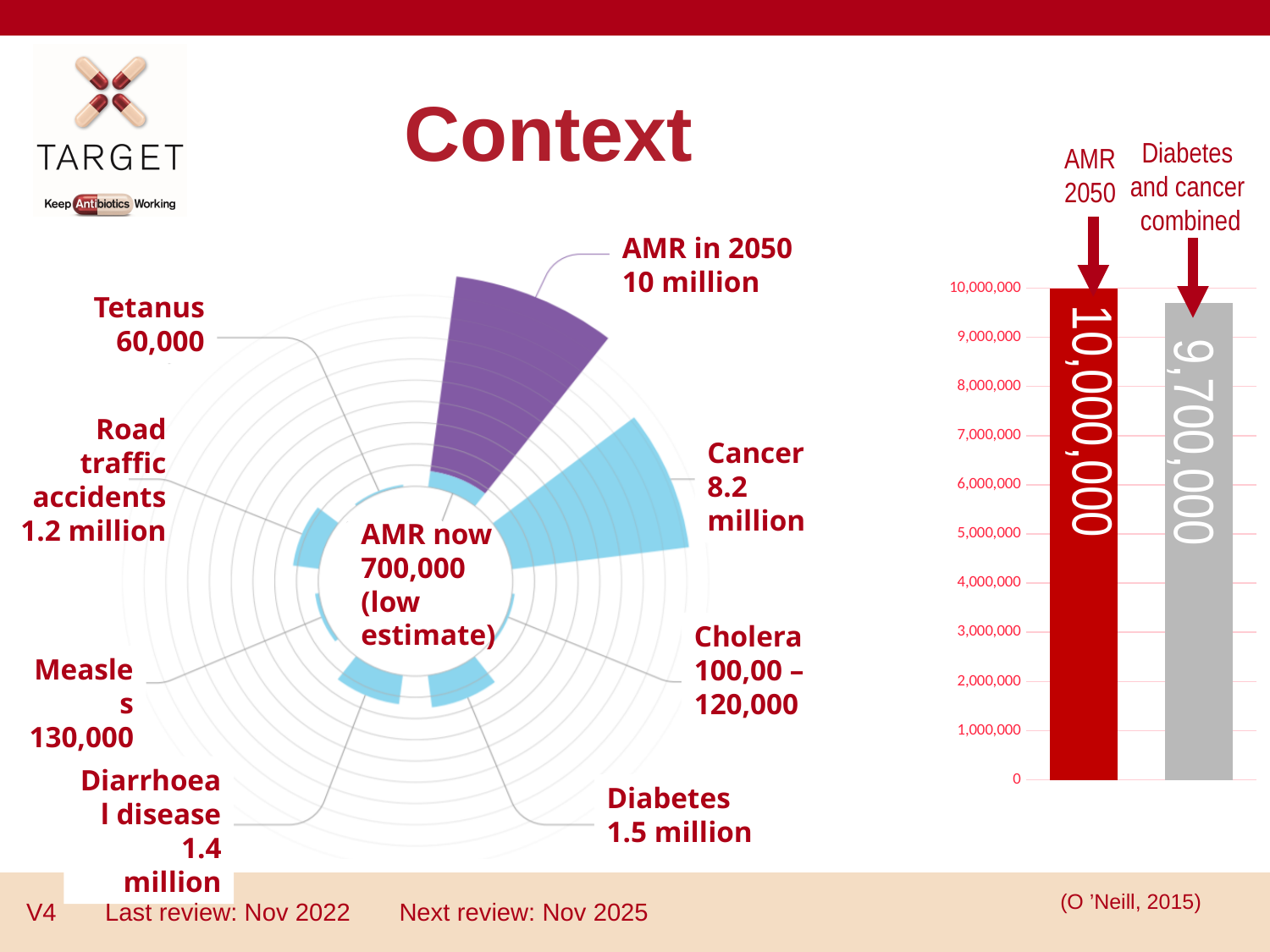
In the bar chart on the right, how many bars are plotted? 2 In the bar chart on the right, what is the value for AMR 2050? 10,000,000 In the radial chart on the left, which category has the largest value? AMR in 2050 In the bar chart on the right, what is the value for Diabetes and cancer combined? 9,700,000 What kind of chart is shown on the right side of the slide? Bar chart In the bar chart on the right, which bar is higher, AMR 2050 or Diabetes and cancer combined? AMR 2050 In the radial chart on the left, what value is given for AMR now (low estimate)? 700,000 In the bar chart on the right, what is the difference between the AMR 2050 value and the Diabetes and cancer combined value? 300,000 In the radial chart on the left, which is larger, Diabetes or Diarrhoeal disease? Diabetes In the bar chart on the right, what is the highest value shown on the vertical axis? 10,000,000 In the radial chart on the left, what value is given for Tetanus? 60,000 In the radial chart on the left, what value is given for Cancer? 8.2 million